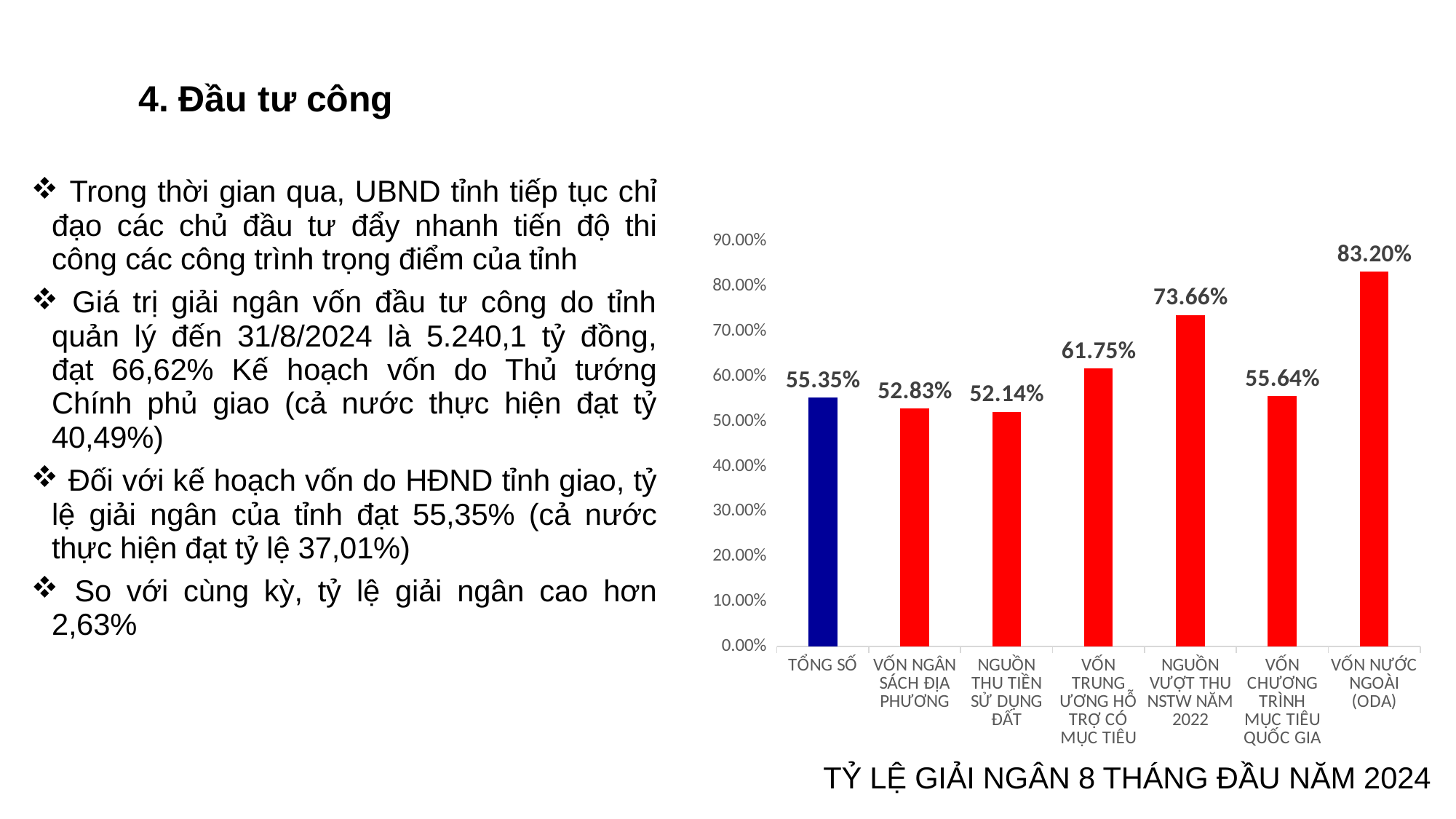
What is the difference between the values for VỐN NƯỚC NGOÀI (ODA) and NGUỒN THU TIỀN SỬ DỤNG ĐẤT? 31.06 percentage points Which is larger, the value for VỐN NGÂN SÁCH ĐỊA PHƯƠNG or the value for VỐN TRUNG ƯƠNG HỖ TRỢ CÓ MỤC TIÊU? VỐN TRUNG ƯƠNG HỖ TRỢ CÓ MỤC TIÊU What is the value for VỐN NƯỚC NGOÀI (ODA)? 83.20% What is the value for VỐN TRUNG ƯƠNG HỖ TRỢ CÓ MỤC TIÊU? 61.75% What is the value for NGUỒN VƯỢT THU NSTW NĂM 2022? 73.66% What is the difference between the values for NGUỒN VƯỢT THU NSTW NĂM 2022 and VỐN TRUNG ƯƠNG HỖ TRỢ CÓ MỤC TIÊU? 11.91 percentage points What kind of chart is shown on the slide? Bar chart Which category has the highest value? VỐN NƯỚC NGOÀI (ODA) Which category has the lowest value? NGUỒN THU TIỀN SỬ DỤNG ĐẤT What is the value for TỔNG SỐ? 55.35% How many categories are shown in the chart? 7 What is the title of the chart? TỶ LỆ GIẢI NGÂN 8 THÁNG ĐẦU NĂM 2024